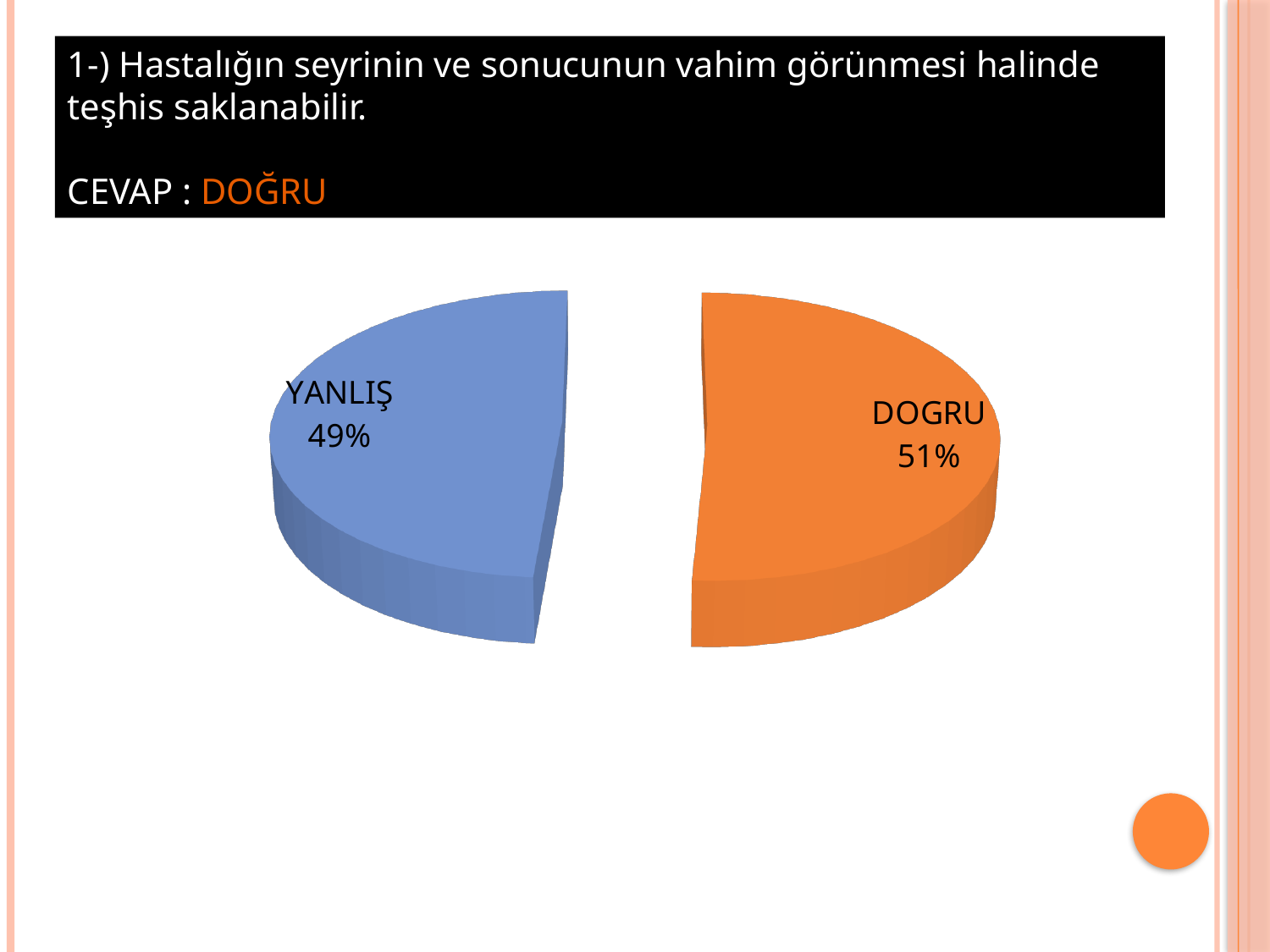
What share of the pie does the YANLIŞ slice represent? 49% What colour is the DOGRU slice? orange Which slice is the smallest in the pie chart? YANLIŞ Is the share for DOGRU greater or less than 50%? greater What is the difference in percentage points between the DOGRU and YANLIŞ slices? 2% How many slices does the pie chart have? 2 Is the share for YANLIŞ greater or less than 50%? less What colour is the YANLIŞ slice? blue What kind of chart is shown on the slide? pie chart What share of the pie does the DOGRU slice represent? 51% Which is larger, the DOGRU slice or the YANLIŞ slice? DOGRU Which slice is the largest in the pie chart? DOGRU